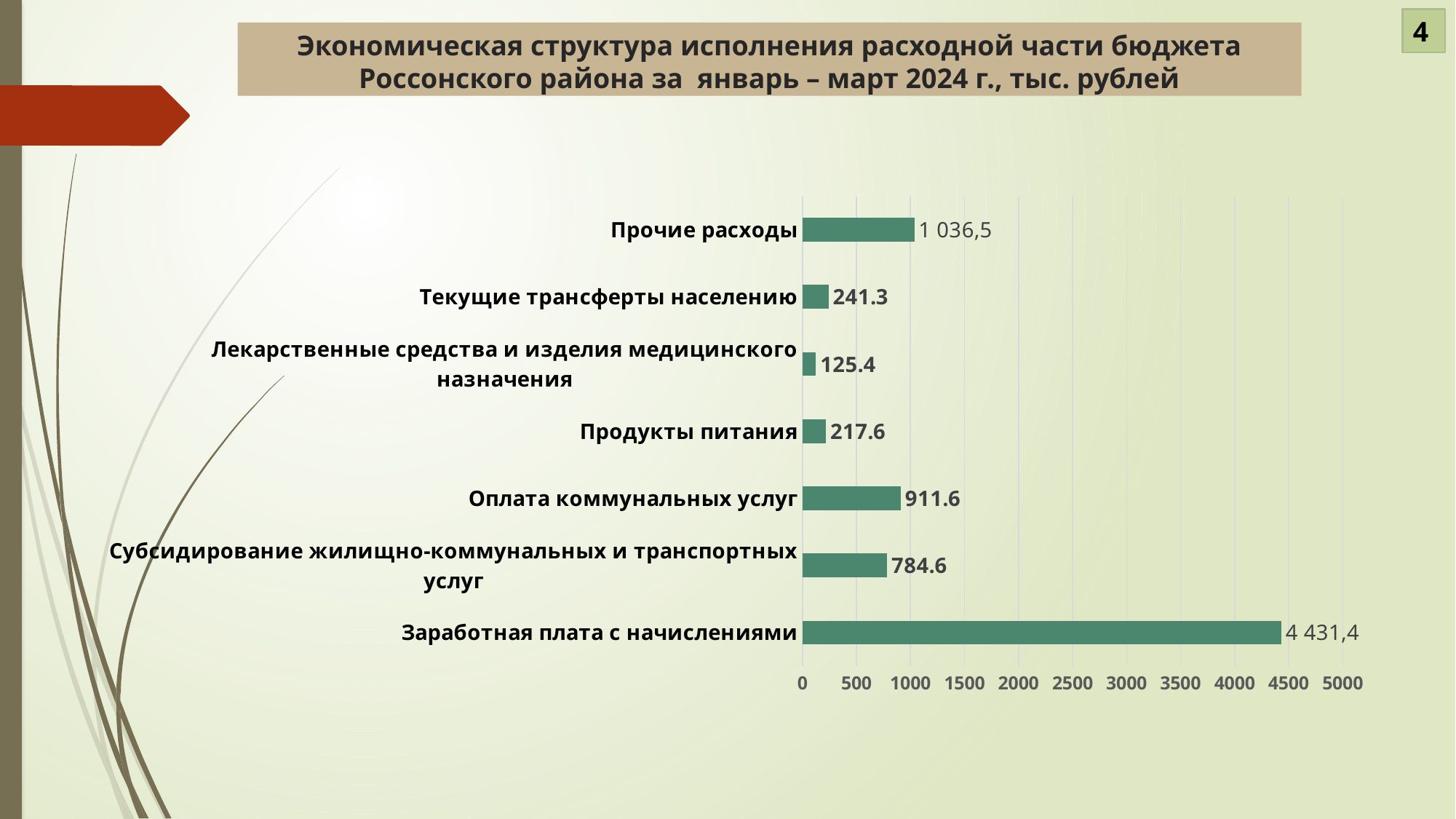
Which is larger: Прочие расходы or Оплата коммунальных услуг? Прочие расходы Which category has the highest value? Заработная плата с начислениями What is the value for Оплата коммунальных услуг? 911.6 Is the value for Заработная плата с начислениями greater or less than 4000? greater How many categories are shown in the chart? 7 What is the value for Лекарственные средства и изделия медицинского назначения? 125.4 What is the value for Прочие расходы? 1 036,5 What kind of chart is shown on the slide? bar chart What is the value for Заработная плата с начислениями? 4 431,4 What is the difference between Текущие трансферты населению and Продукты питания? 23.7 What is the difference between Оплата коммунальных услуг and Субсидирование жилищно-коммунальных и транспортных услуг? 127.0 Which category has the lowest value? Лекарственные средства и изделия медицинского назначения